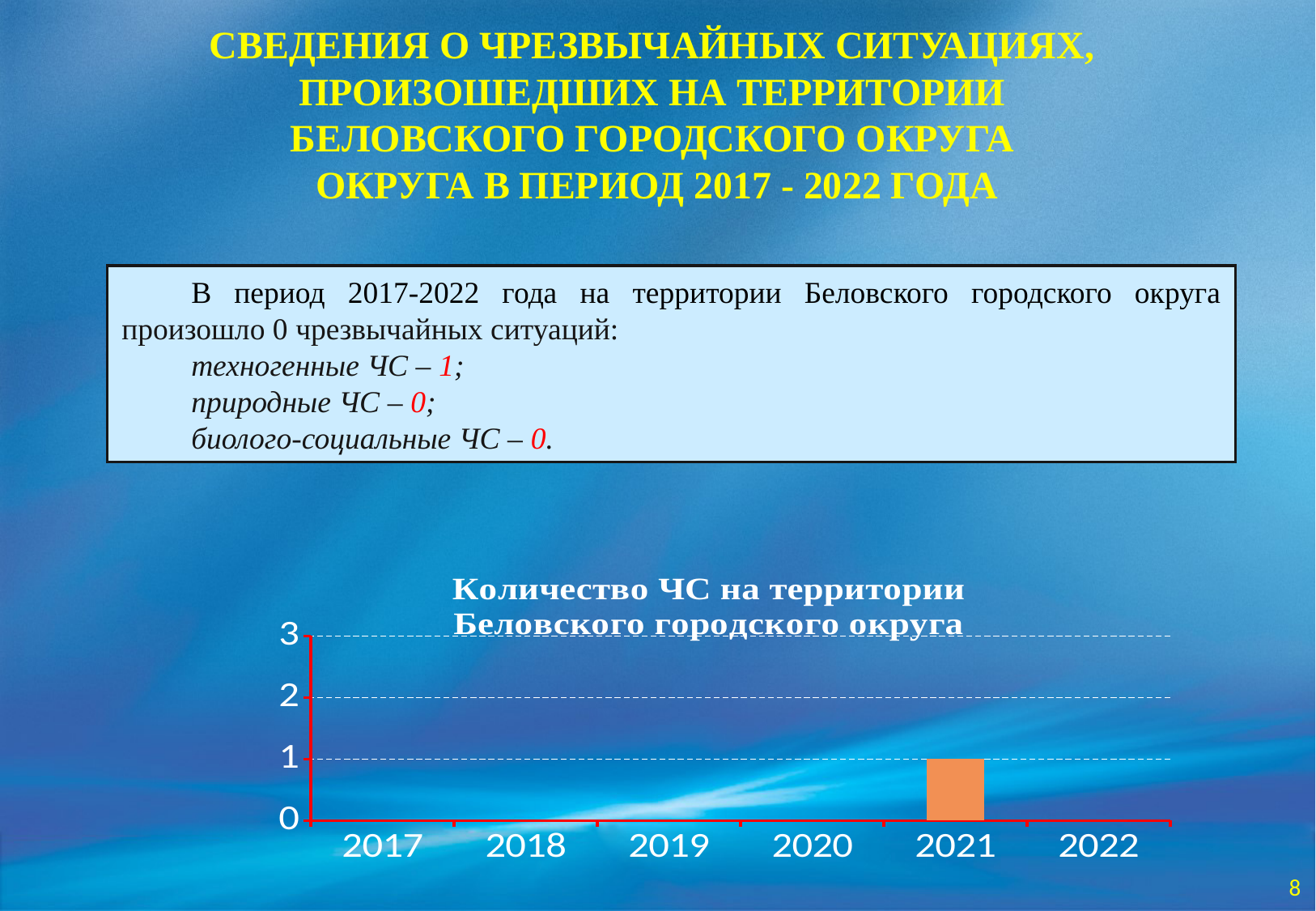
How many years are shown on the x axis of the chart? 6 What kind of chart is shown on the slide? bar chart What is the title of the chart? Количество ЧС на территории Беловского городского округа What is the difference between the value for 2021 and the value for 2022? 1 What is the value for 2021 in the chart? 1 How many years in the chart have a visible bar? 1 Which year has the highest value in the chart? 2021 What is the value for 2019 in the chart? 0 Which is larger, the value for 2021 or the value for 2020? 2021 What is the highest tick value shown on the y axis of the chart? 3 Is the value for 2021 greater or less than 2? less